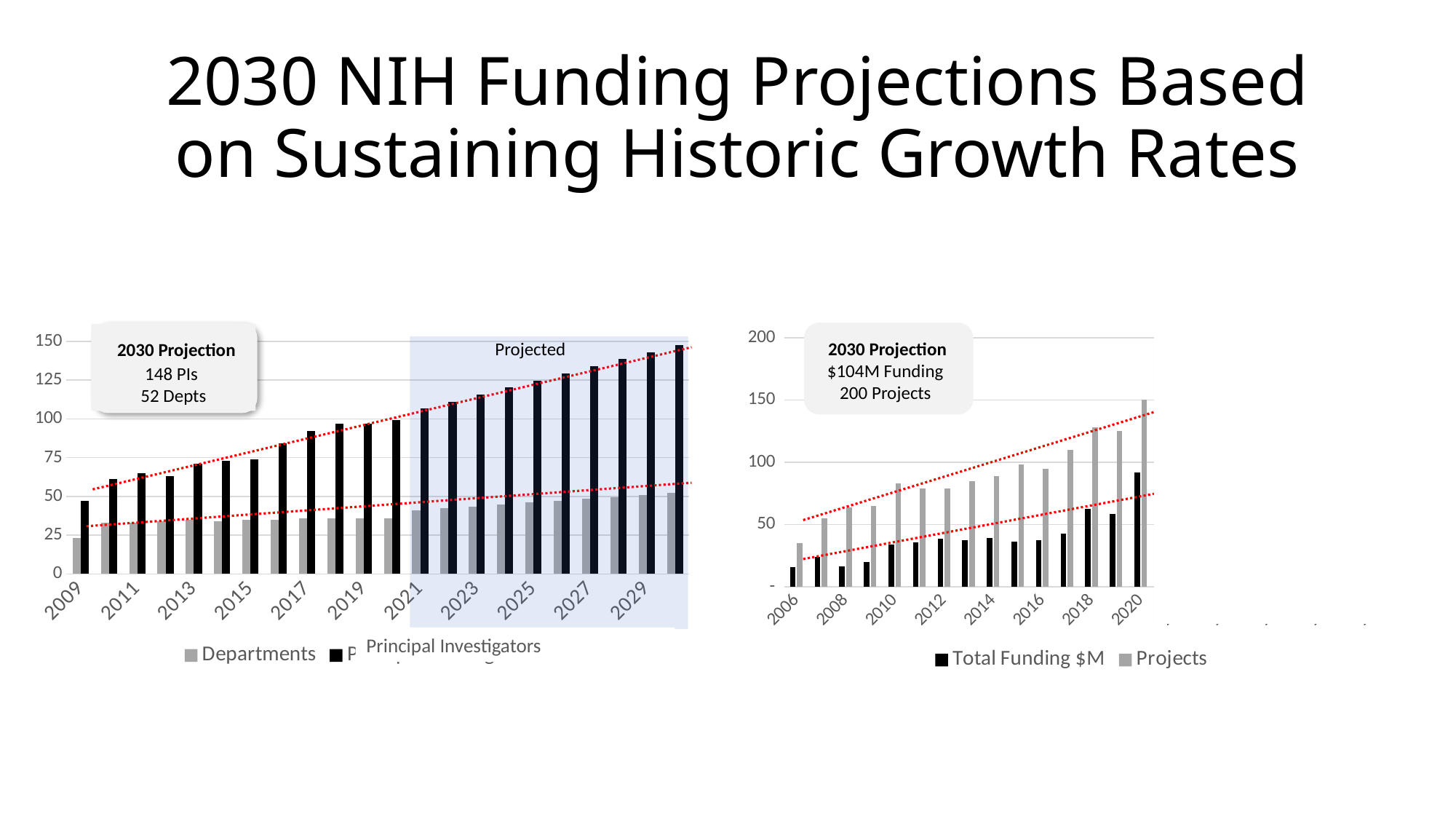
In the right chart, which series has the larger value in 2010, Total Funding $M or Projects? Projects In the left chart, is the value for Principal Investigators in 2017 greater or less than 75? greater In the right chart, is the value for Total Funding $M in 2006 greater or less than 50? less In the left chart, is the value for Principal Investigators in 2009 greater or less than 50? less In the left chart, which series has the larger value in 2015, Departments or Principal Investigators? Principal Investigators In the left chart, do the Principal Investigators values rise or fall from 2009 to 2030? rise What kind of chart is the left chart showing Departments and Principal Investigators? bar chart In the right chart, which year has the lowest value for Projects? 2006 How many series does the legend of the right chart list? 2 According to the callout on the right chart, what is the 2030 projected funding? $104M